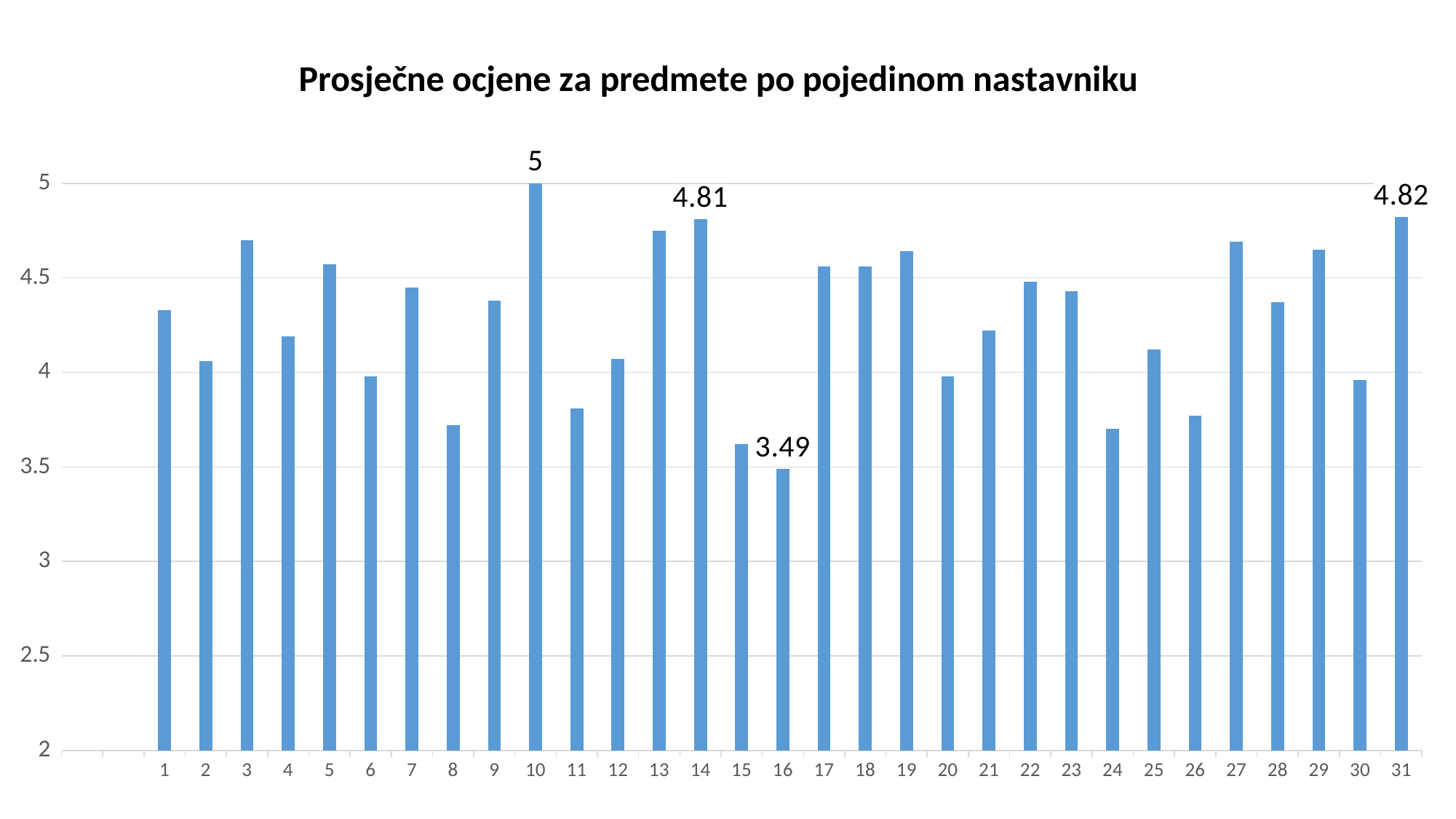
What is the value for teacher 10? 5 What is the value for teacher 16? 3.49 What is the value for teacher 14? 4.81 What is the difference between the values for teacher 10 and teacher 16? 1.51 Which teacher has the lowest average grade? 16 What is the title of the chart? Prosječne ocjene za predmete po pojedinom nastavniku Is the value for teacher 8 greater or less than 4? less Which teacher has the highest average grade? 10 What kind of chart is shown on the slide? bar chart How many teachers (categories) are shown on the x axis? 31 Which has a larger value, teacher 14 or teacher 31? 31 What is the value for teacher 31? 4.82